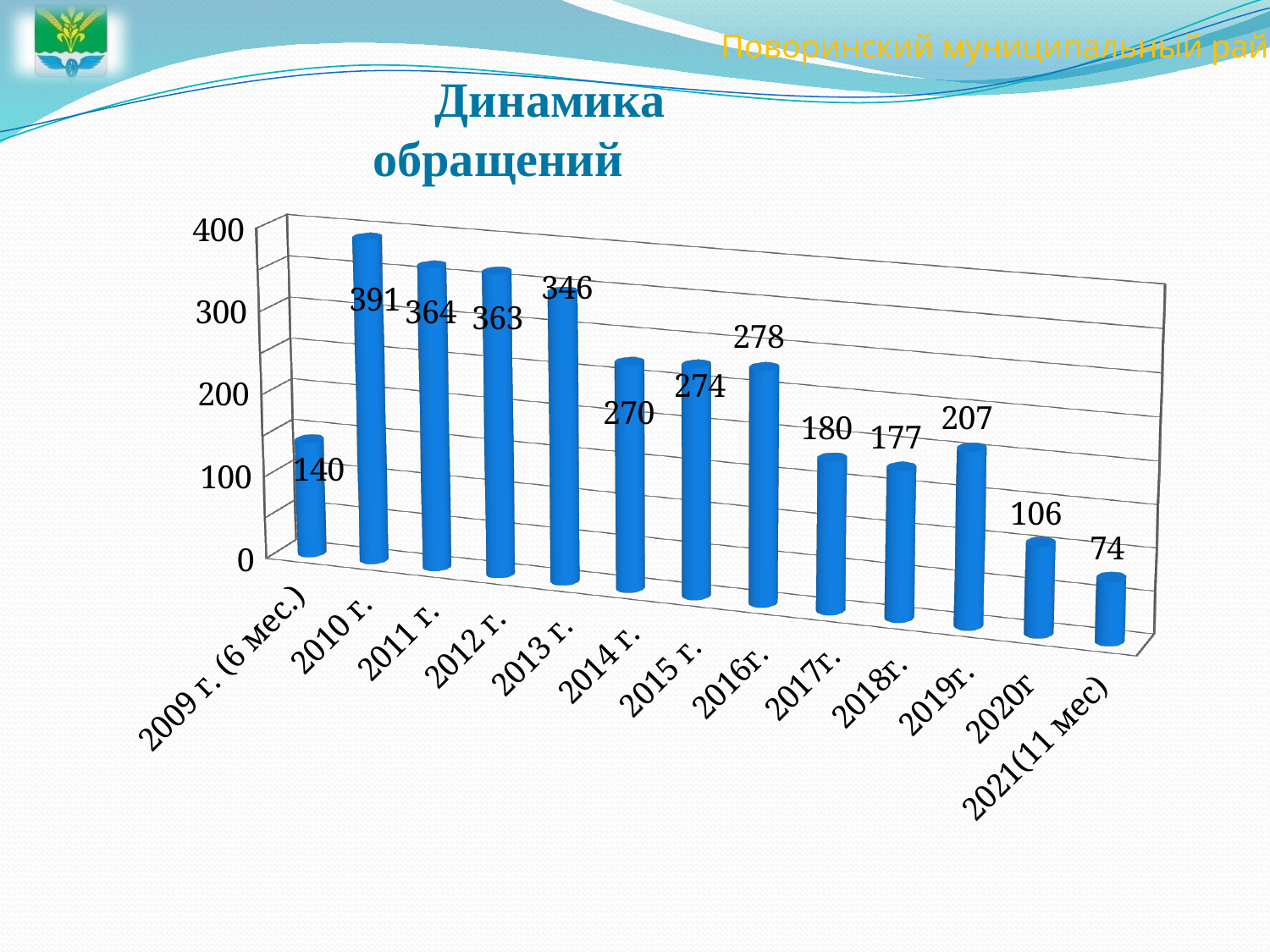
Which category has the lowest value? 2021(11 мес) How many categories are shown on the x axis? 13 What is the value for 2013 г.? 346 What is the value for 2010 г.? 391 What is the title of the chart? Динамика обращений What is the value for 2021(11 мес)? 74 Do the values generally rise or fall from 2013 г. to 2021(11 мес)? fall Which year has the highest value? 2010 г. What is the difference between the values for 2010 г. and 2020г? 285 Which is larger, the value for 2019г. or the value for 2017г.? 2019г. What kind of chart is shown on the slide? bar chart What is the value for 2009 г. (6 мес.)? 140